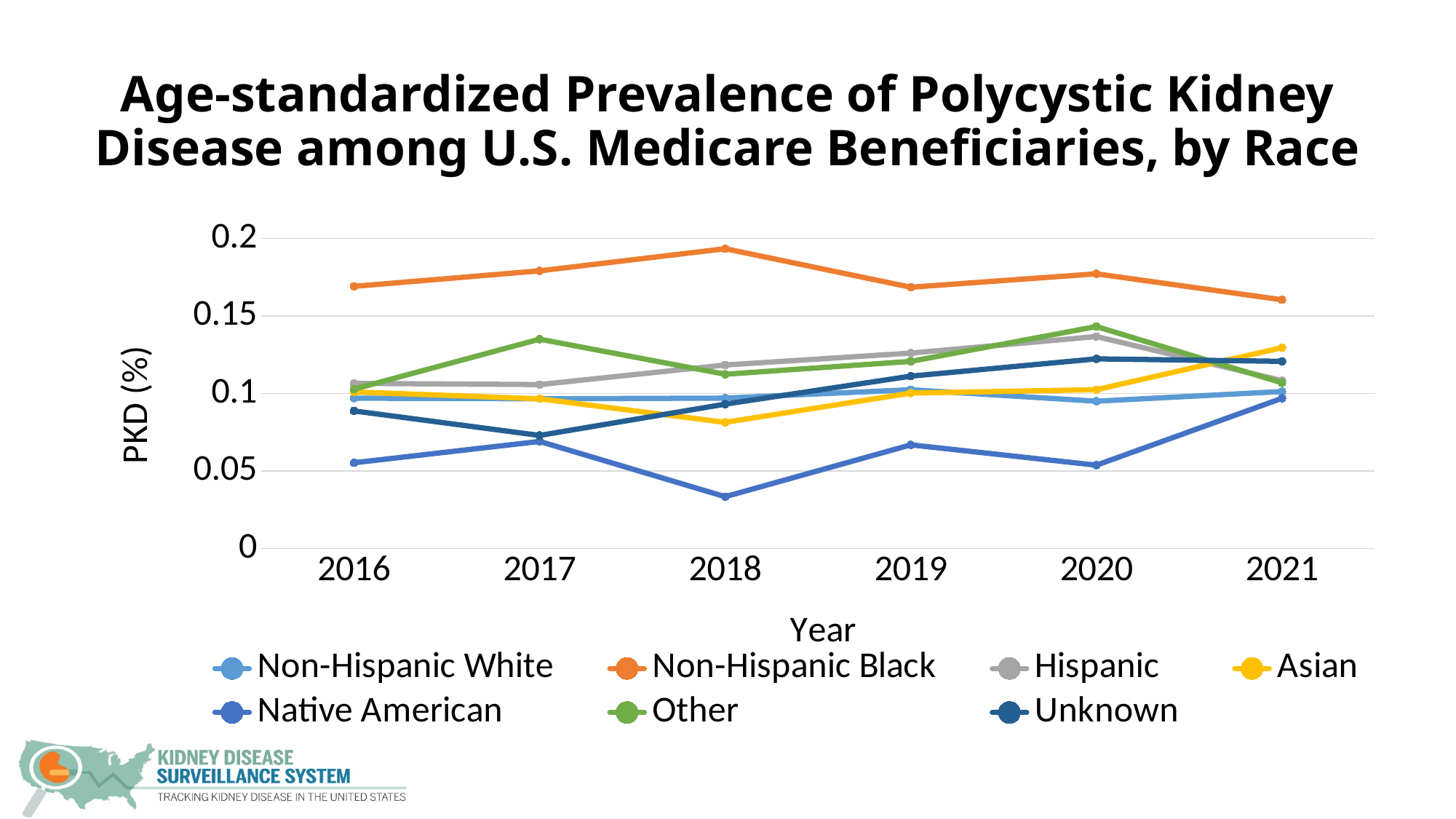
How many years are plotted along the x axis? 6 Is the value for Unknown in 2017 greater or less than 0.1? less What kind of chart is shown on the slide? line chart Does the Native American line rise or fall from 2020 to 2021? rise What is the label on the y axis? PKD (%) Does the Non-Hispanic Black line rise or fall from 2020 to 2021? fall In 2017, which is higher: Other or Hispanic? Other How many series does the legend list? 7 Is the value for Native American in 2018 greater or less than 0.05? less Which series has the highest value in 2018? Non-Hispanic Black Is the value for Non-Hispanic Black in 2018 greater or less than 0.15? greater Which series has the lowest value in 2018? Native American